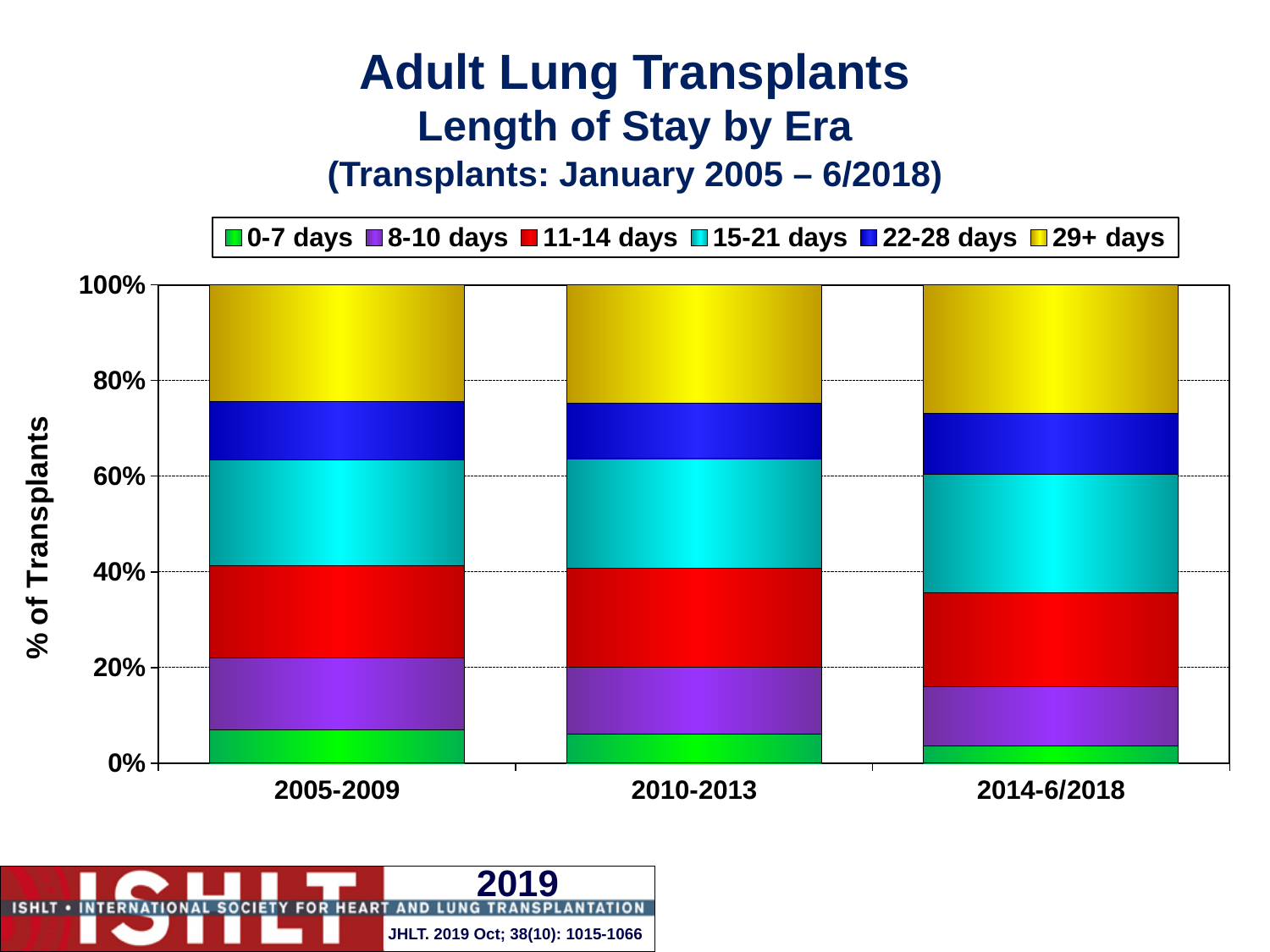
Is the cumulative top of the 15-21 days segment in the 2010-2013 bar greater or less than 60%? greater How many eras (categories) are shown on the x axis? 3 Is the share of 0-7 days stays in 2005-2009 greater or less than 20%? less Which era has the smallest share of 0-7 days stays? 2014-6/2018 What is the label of the y axis? % of Transplants Is the cumulative top of the 22-28 days segment in the 2005-2009 bar greater or less than 80%? less How many series does the legend list? 6 What is the total of the stacked bar for 2005-2009? 100% Which length-of-stay category is shown in yellow in the legend? 29+ days What kind of chart is shown on the slide? Stacked bar chart Is the share of 0-7 days stays larger in 2005-2009 or in 2014-6/2018? 2005-2009